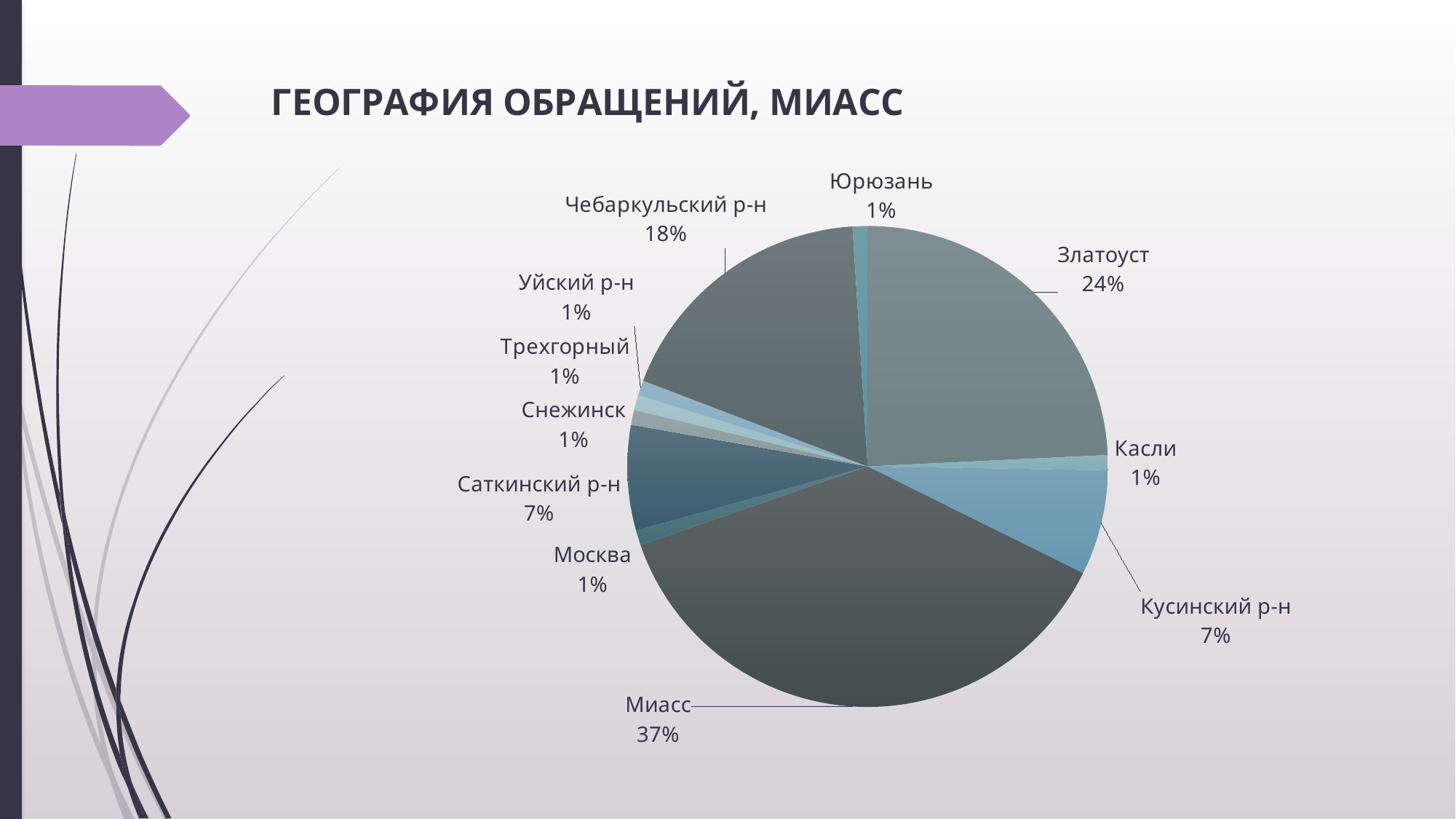
What is the title of the chart? ГЕОГРАФИЯ ОБРАЩЕНИЙ, МИАСС What share of the pie does Златоуст have? 24% What is the value for Кусинский р-н? 7% How many categories are shown in the pie chart? 11 What kind of chart is shown on the slide? pie chart What share of the pie does Чебаркульский р-н have? 18% Which is larger, the share of Златоуст or the share of Чебаркульский р-н? Златоуст What share of the pie does Миасс have? 37% What is the difference between the shares of Миасс and Златоуст? 13% What is the value for Саткинский р-н? 7% Which category has the largest slice of the pie? Миасс What is the value for Снежинск? 1%